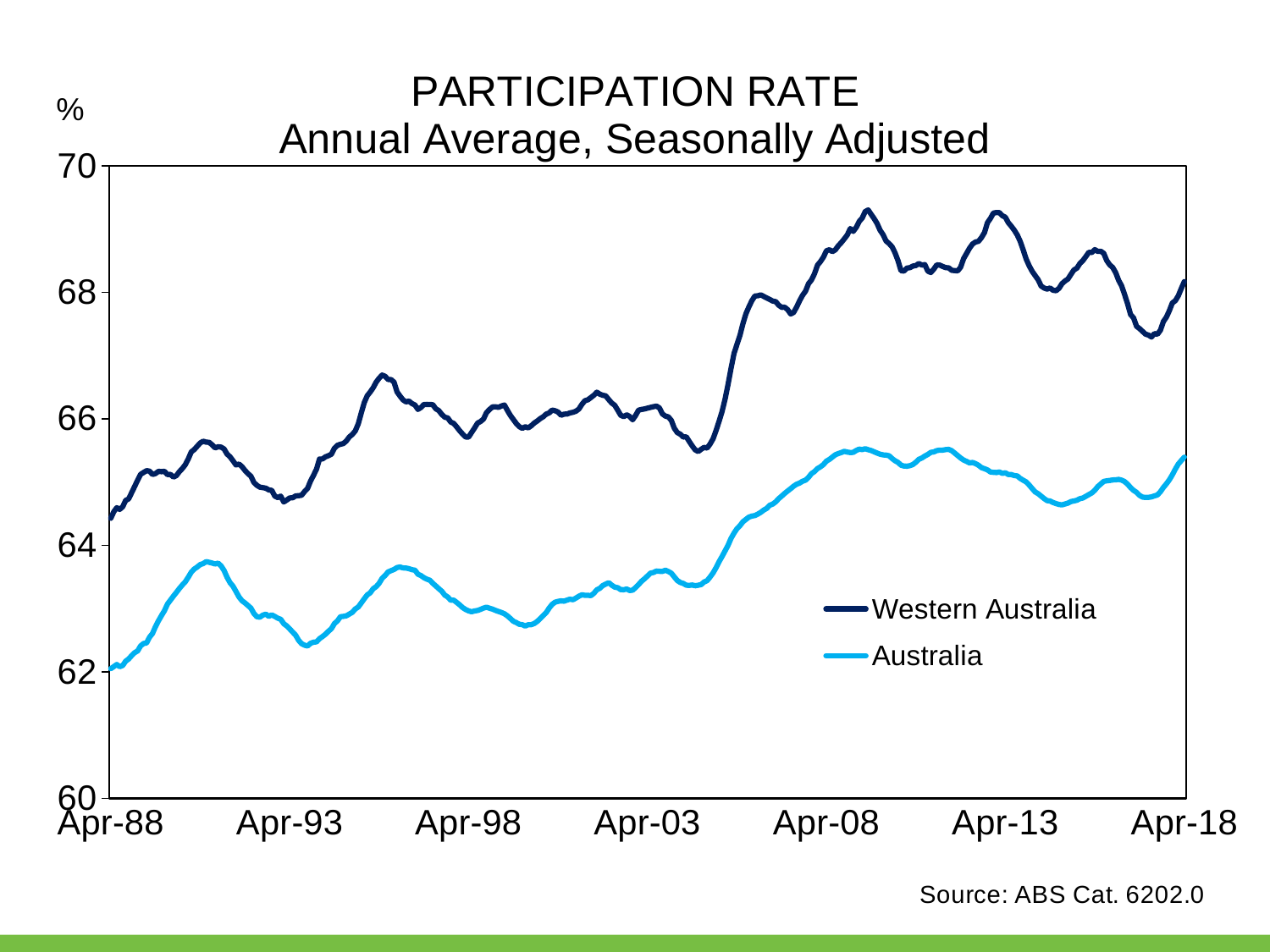
How many series does the legend list? 2 Does the Western Australia series ever reach 70 on the chart? No Is the value for Western Australia at Apr-88 greater or less than 64? greater What is the title of the chart? PARTICIPATION RATE Annual Average, Seasonally Adjusted Does the Australia participation rate overall rise or fall between Apr-88 and Apr-18? rise Which series has the higher participation rate at Apr-18? Western Australia What are the two series named in the legend? Western Australia and Australia Is the value for Australia at Apr-18 greater or less than 66? less Which series is higher than the other across the whole period shown? Western Australia What kind of chart is shown on the slide? line chart